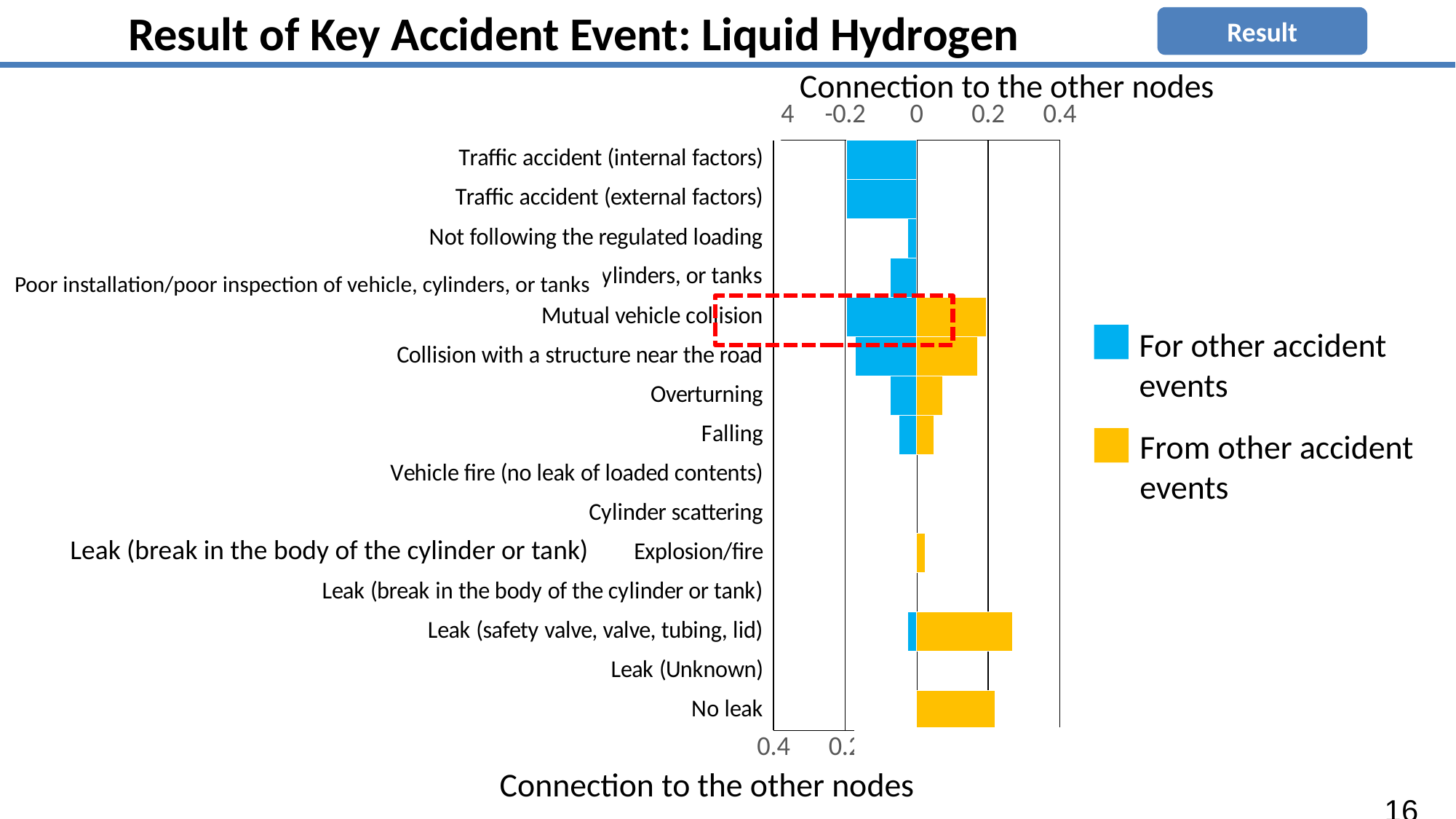
How many accident event categories are plotted on the chart? 15 Which category has the largest 'From other accident events' value? Leak (safety valve, valve, tubing, lid) Which has the larger 'From other accident events' value, No leak or Falling? No leak What is the axis title of the chart? Connection to the other nodes What kind of chart is shown on the slide? bar chart Which series is shown in blue in the legend? For other accident events Which has the larger 'From other accident events' value, Collision with a structure near the road or Falling? Collision with a structure near the road Is the 'From other accident events' value for Overturning greater or less than 0.2? less Is the 'From other accident events' value for Leak (safety valve, valve, tubing, lid) greater or less than 0.2? greater Is the 'From other accident events' value for Explosion/fire greater or less than 0.2? less How many series does the legend list? 2 Which has the larger 'From other accident events' value, Leak (safety valve, valve, tubing, lid) or Overturning? Leak (safety valve, valve, tubing, lid)